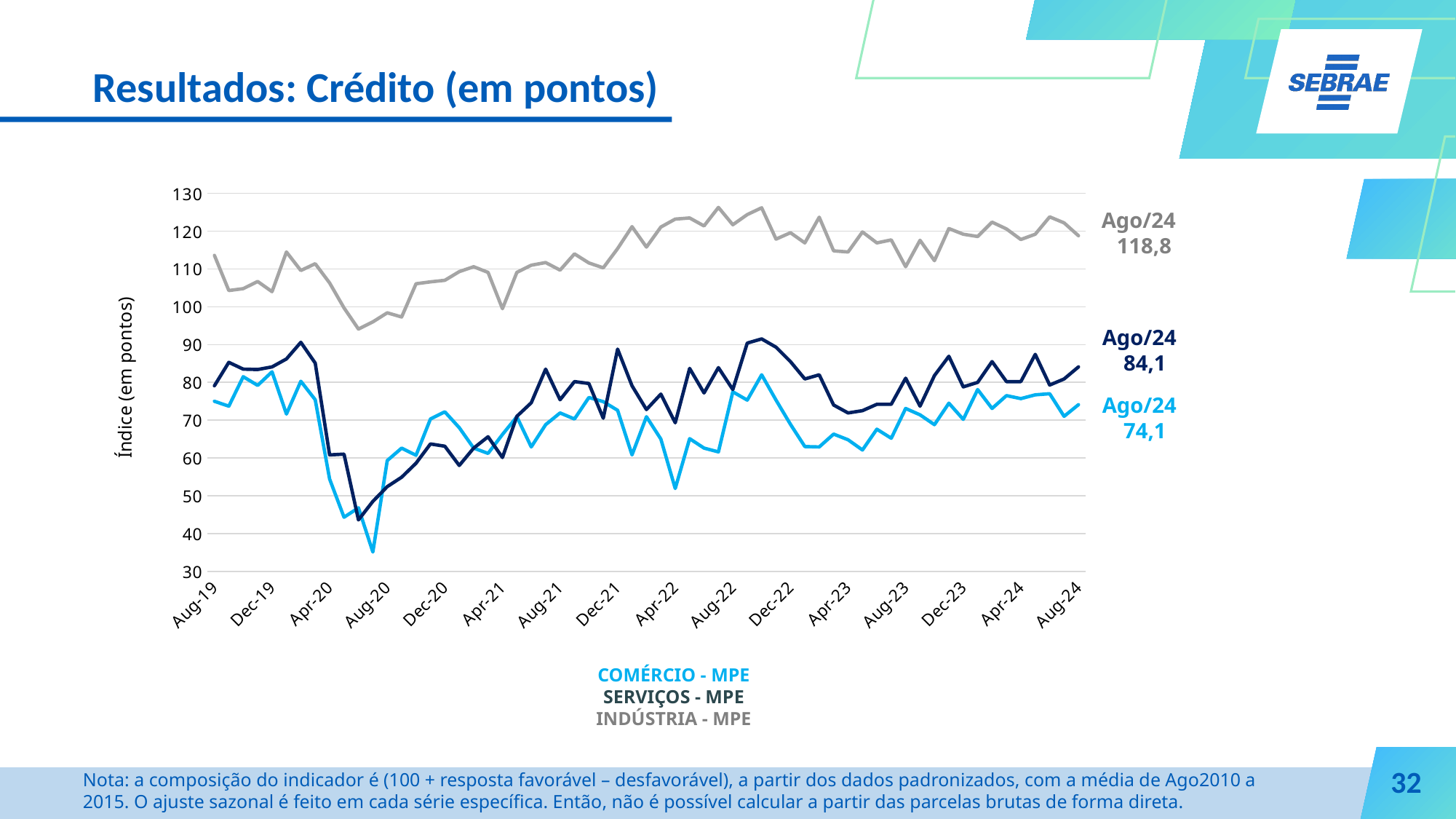
How many series does the legend list? 3 Which series has the lowest value in Ago/24? COMÉRCIO - MPE What is the difference between the Ago/24 values of SERVIÇOS - MPE and COMÉRCIO - MPE? 10,0 What is the value of INDÚSTRIA - MPE in Ago/24? 118,8 In Ago/24, which is larger: SERVIÇOS - MPE or COMÉRCIO - MPE? SERVIÇOS - MPE Which series has the highest value in Ago/24? INDÚSTRIA - MPE What is the label of the vertical axis? Índice (em pontos) What is the value of COMÉRCIO - MPE in Ago/24? 74,1 What is the value of SERVIÇOS - MPE in Ago/24? 84,1 What kind of chart is shown on the slide? Line chart What is the difference between the Ago/24 values of INDÚSTRIA - MPE and SERVIÇOS - MPE? 34,7 Is the lowest value of COMÉRCIO - MPE (around Aug-20) greater or less than 40? less